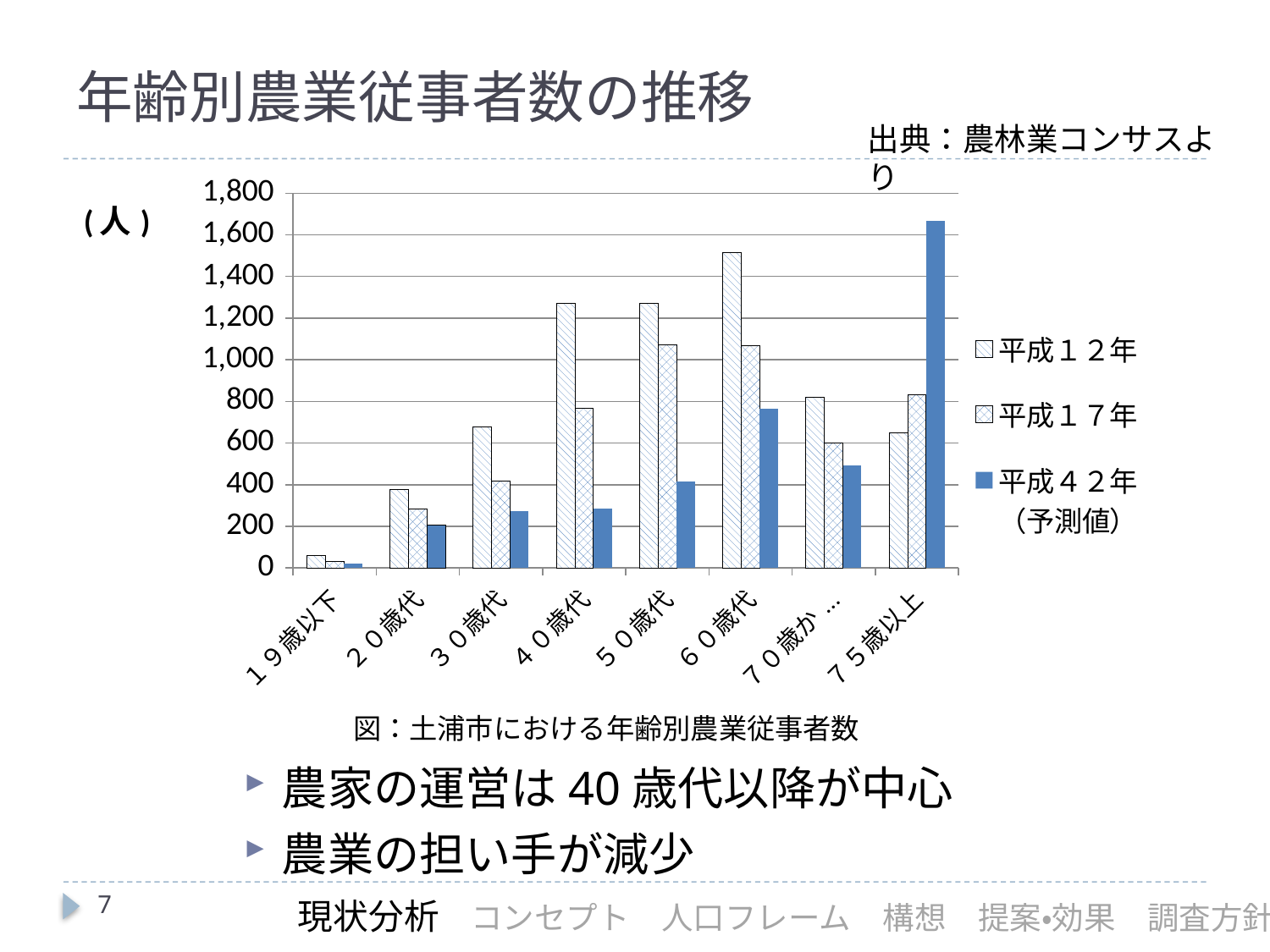
Is the 平成４２年 value for ３０歳代 greater or less than 400? less For ４０歳代, which is larger: the 平成１２年 value or the 平成４２年 value? 平成１２年 How many series does the legend list? 3 Which age group has the lowest value for 平成１２年? １９歳以下 What kind of chart is shown on the slide? bar chart What unit is shown for the vertical axis? （人） Is the 平成４２年 value for ７５歳以上 greater or less than 1,400? greater For ７５歳以上, which is larger: the 平成１２年 value or the 平成４２年 value? 平成４２年 Which age group has the highest value for 平成１２年? ６０歳代 How many age-group categories are shown on the x axis? 8 Which age group has the highest value for 平成４２年? ７５歳以上 Is the 平成１２年 value for ６０歳代 greater or less than 1,400? greater